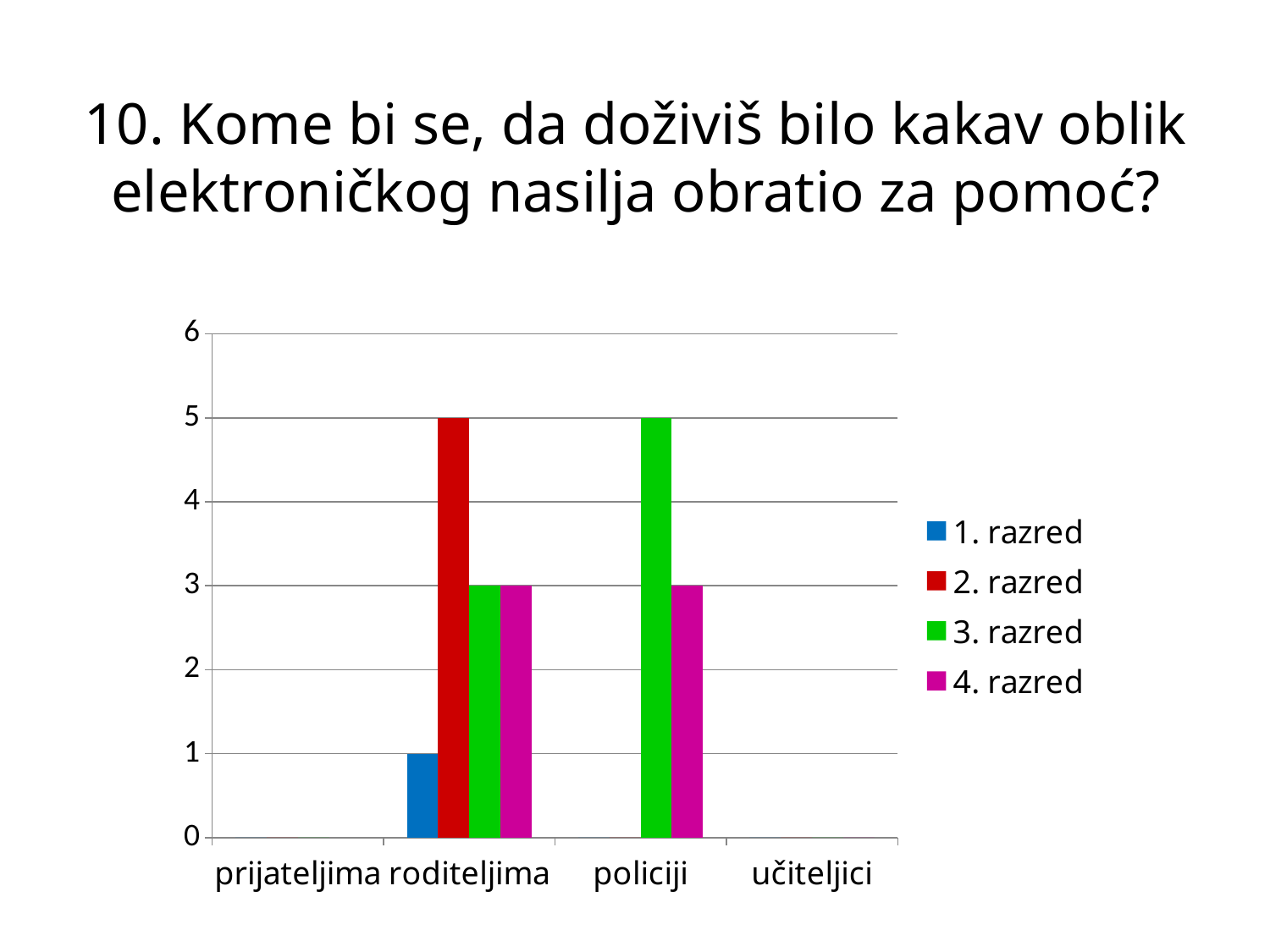
What is the value for 1. razred in the roditeljima category? 1 What is the value for 2. razred in the roditeljima category? 5 Which series has the highest value in the roditeljima category? 2. razred Which series is shown in green in the legend? 3. razred How many series does the legend list? 4 What is the difference between the 2. razred and 1. razred values in the roditeljima category? 4 How many categories are shown on the x axis? 4 What is the value for 4. razred in the policiji category? 3 Which series has the lowest visible bar in the roditeljima category? 1. razred Which is larger: the 3. razred value for policiji or the 4. razred value for policiji? 3. razred What kind of chart is shown on the slide? bar chart What is the value for 3. razred in the policiji category? 5